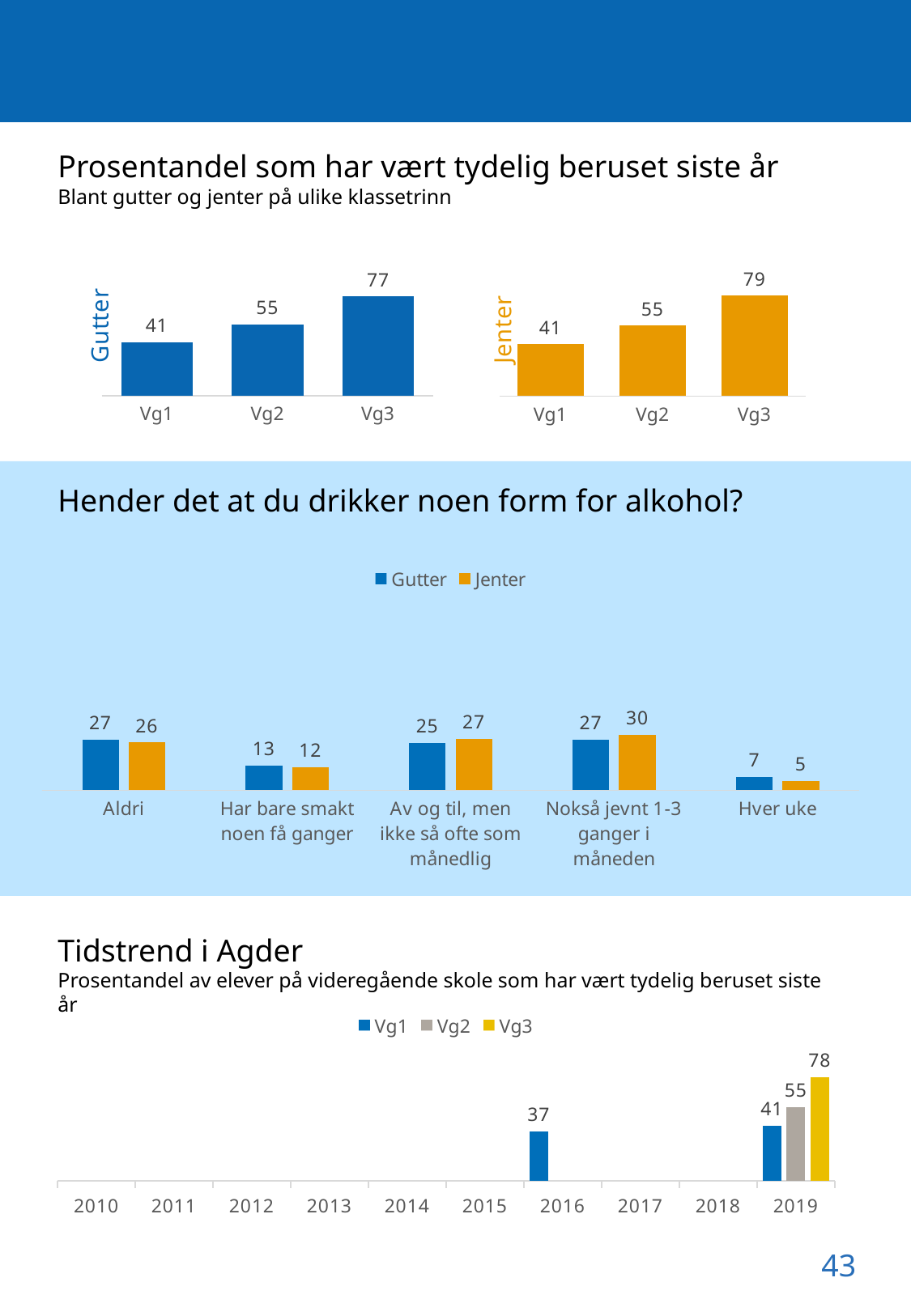
In the chart 'Hender det at du drikker noen form for alkohol?', how many series does the legend list? 2 In the chart 'Hender det at du drikker noen form for alkohol?', how many categories are shown on the x axis? 5 In the top chart 'Prosentandel som har vært tydelig beruset siste år', what is the value for Jenter in Vg3? 79 In the top chart 'Prosentandel som har vært tydelig beruset siste år', what is the difference between the Jenter Vg3 value and the Jenter Vg1 value? 38 In the top chart 'Prosentandel som har vært tydelig beruset siste år', what is the value for Gutter in Vg3? 77 In the chart 'Hender det at du drikker noen form for alkohol?', what is the value for Jenter in the category 'Nokså jevnt 1-3 ganger i måneden'? 30 In the chart 'Hender det at du drikker noen form for alkohol?', which category has the lowest value for Jenter? Hver uke In the top chart 'Prosentandel som har vært tydelig beruset siste år', do the Gutter values rise or fall from Vg1 to Vg3? rise In the chart 'Hender det at du drikker noen form for alkohol?', what is the value for Gutter in the category 'Hver uke'? 7 In the chart 'Tidstrend i Agder', which series has the highest value in 2019? Vg3 What kind of chart is 'Tidstrend i Agder'? bar chart In the chart 'Tidstrend i Agder', what is the value for Vg1 in 2016? 37